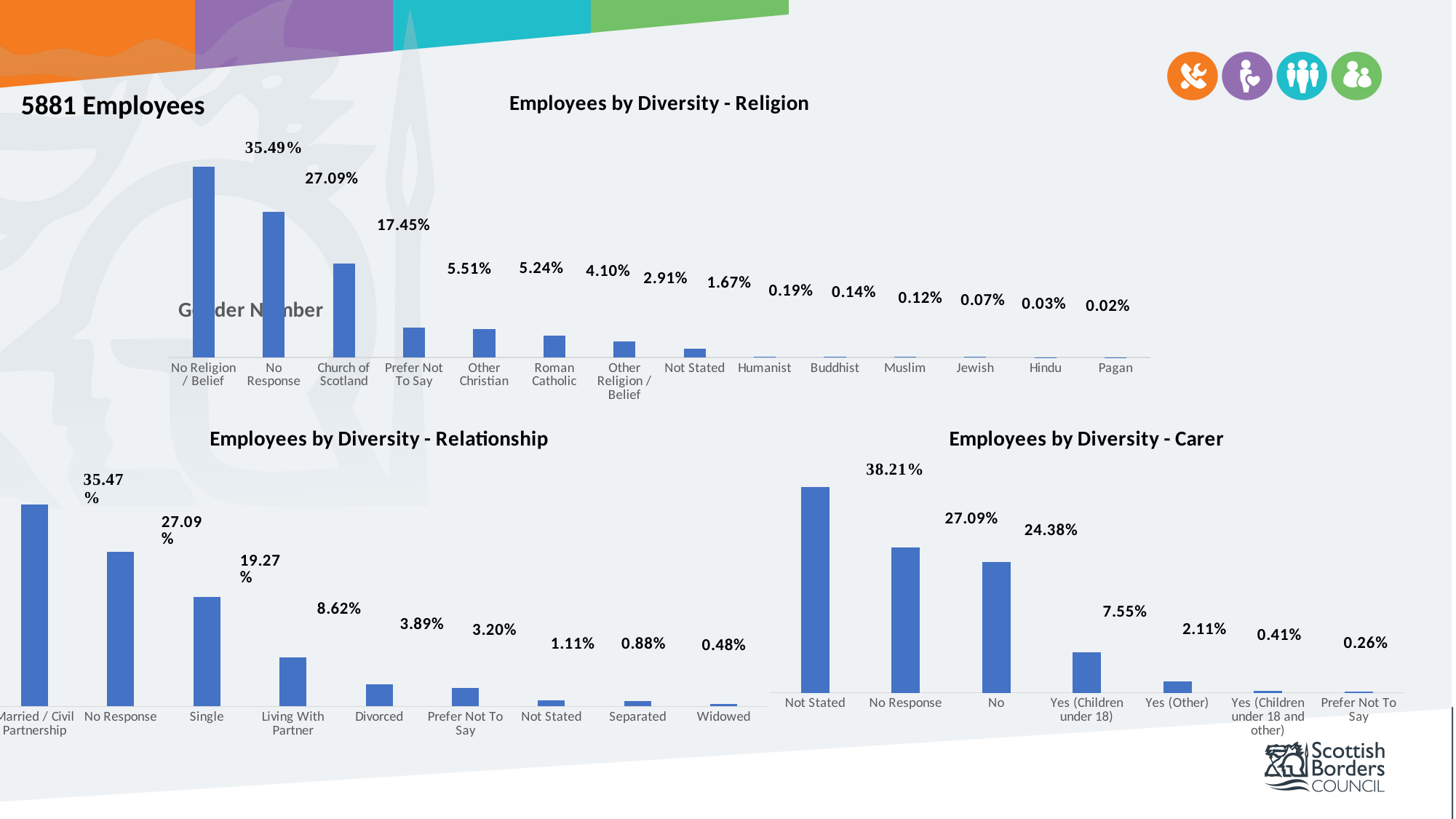
In the 'Employees by Diversity - Carer' chart, what percentage is shown for Yes (Children under 18)? 7.55% What type of chart is 'Employees by Diversity - Carer'? Bar chart In the 'Employees by Diversity - Religion' chart, how many categories are shown on the x axis? 14 In the 'Employees by Diversity - Relationship' chart, which category has the highest value? Married / Civil Partnership In the 'Employees by Diversity - Religion' chart, what percentage is shown for Church of Scotland? 17.45% In the 'Employees by Diversity - Religion' chart, what is the difference between No Religion / Belief and No Response? 8.40% In the 'Employees by Diversity - Relationship' chart, what percentage is shown for Living With Partner? 8.62% In the 'Employees by Diversity - Carer' chart, what is the difference between No Response and No? 2.71% In the 'Employees by Diversity - Religion' chart, which category has the lowest value? Pagan In the 'Employees by Diversity - Relationship' chart, which is larger: Divorced or Prefer Not To Say? Divorced In the 'Employees by Diversity - Relationship' chart, how many categories are shown? 9 In the 'Employees by Diversity - Carer' chart, which category has the highest value? Not Stated